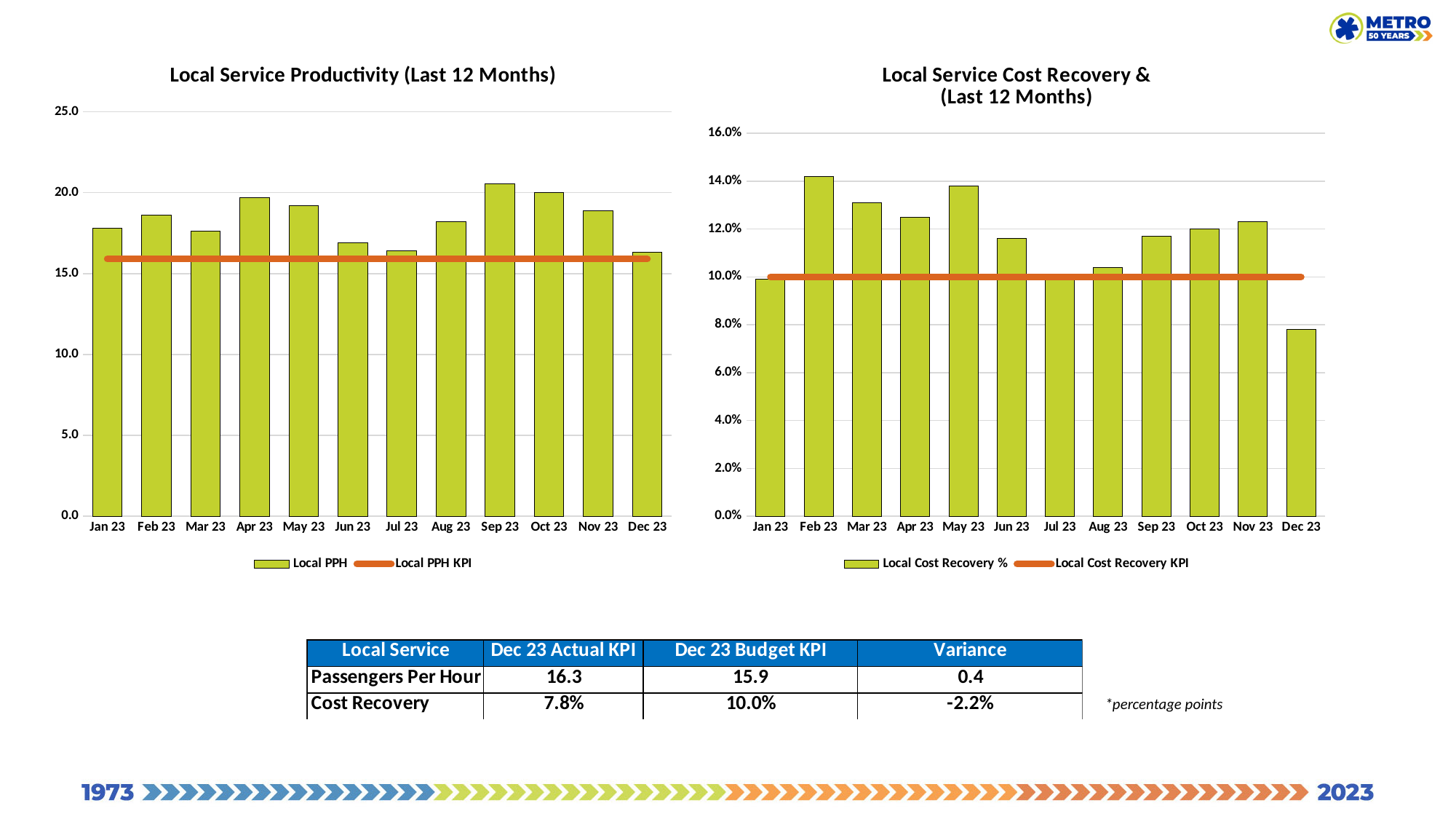
On the Local Service Cost Recovery chart, what is the value of the Local Cost Recovery KPI line? 10.0% How many months are shown on the Local Service Productivity chart? 12 On the Local Service Cost Recovery chart, is the Dec 23 Local Cost Recovery % higher or lower than the Local Cost Recovery KPI? lower On the Local Service Cost Recovery chart, which month has the lowest Local Cost Recovery %? Dec 23 On the Local Service Productivity chart, is the Local PPH for Apr 23 greater or less than 15.0? greater On the Local Service Productivity chart, what is the difference between the Dec 23 Local PPH and the Local PPH KPI? 0.4 On the Local Service Cost Recovery chart, what is the Local Cost Recovery % for Dec 23? 7.8% How many series does the legend of the Local Service Cost Recovery chart list? 2 On the Local Service Productivity chart, which month has the highest Local PPH? Sep 23 On the Local Service Cost Recovery chart, which month has the highest Local Cost Recovery %? Feb 23 On the Local Service Cost Recovery chart, is the Local Cost Recovery % for Feb 23 greater or less than 12.0%? greater On the Local Service Productivity chart, what is the Local PPH value for Dec 23? 16.3